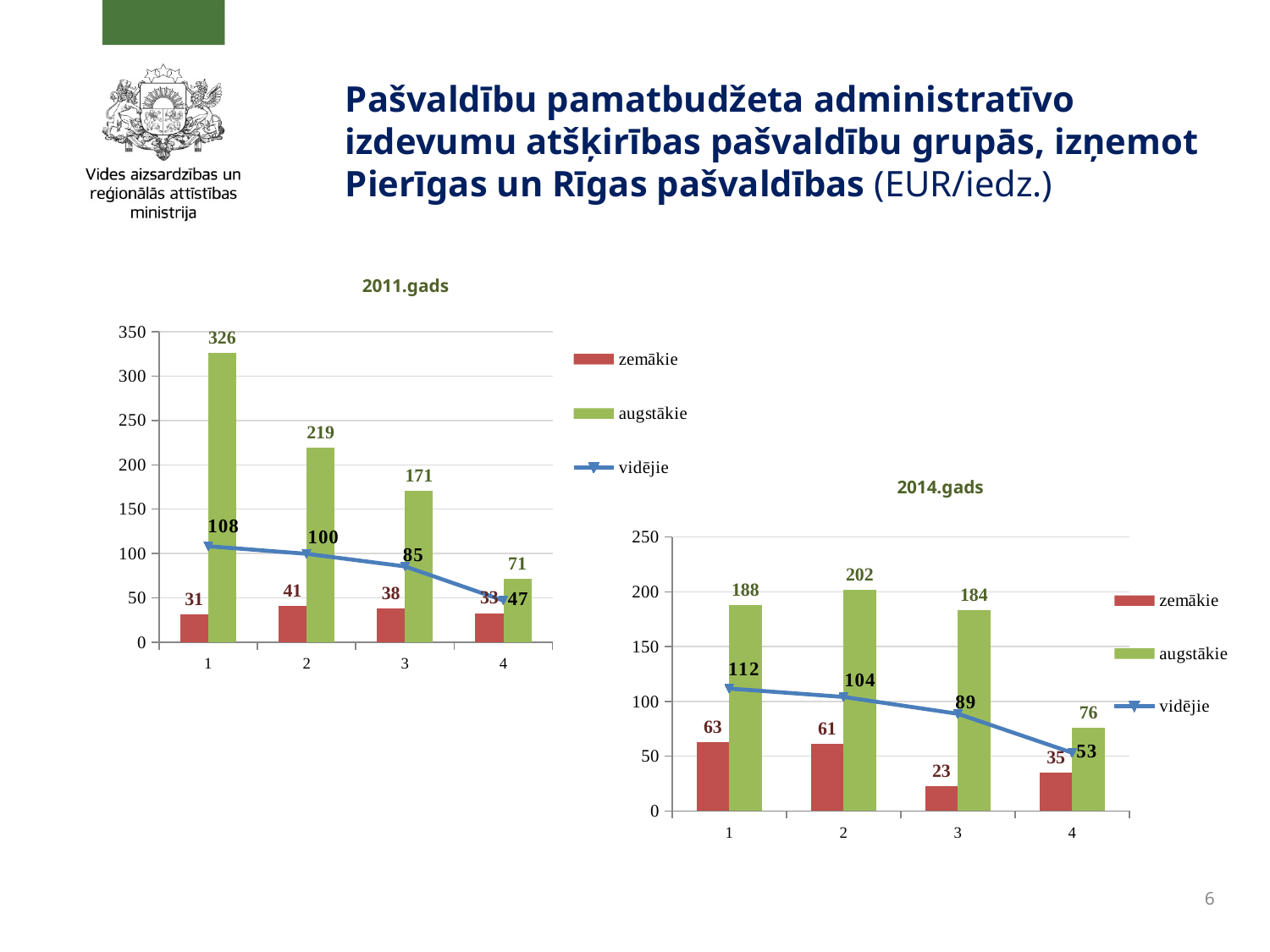
In the 2011.gads chart, what is the augstākie value for group 1? 326 In the 2014.gads chart, what colour are the augstākie bars? green In the 2011.gads chart, which is larger: the vidējie value for group 2 or the vidējie value for group 3? group 2 What kind of chart is the 2011.gads chart? combined bar and line chart In the 2011.gads chart, which group has the lowest zemākie value? 1 In the 2014.gads chart, which group has the highest augstākie value? 2 In the 2014.gads chart, what is the zemākie value for group 3? 23 In the 2014.gads chart, does the vidējie line rise or fall from group 1 to group 4? fall In the 2011.gads chart, what is the vidējie value for group 4? 47 How many series does the legend of the 2014.gads chart list? 3 How many groups are shown on the x axis of the 2011.gads chart? 4 In the 2014.gads chart, what is the difference between the augstākie and zemākie values for group 1? 125